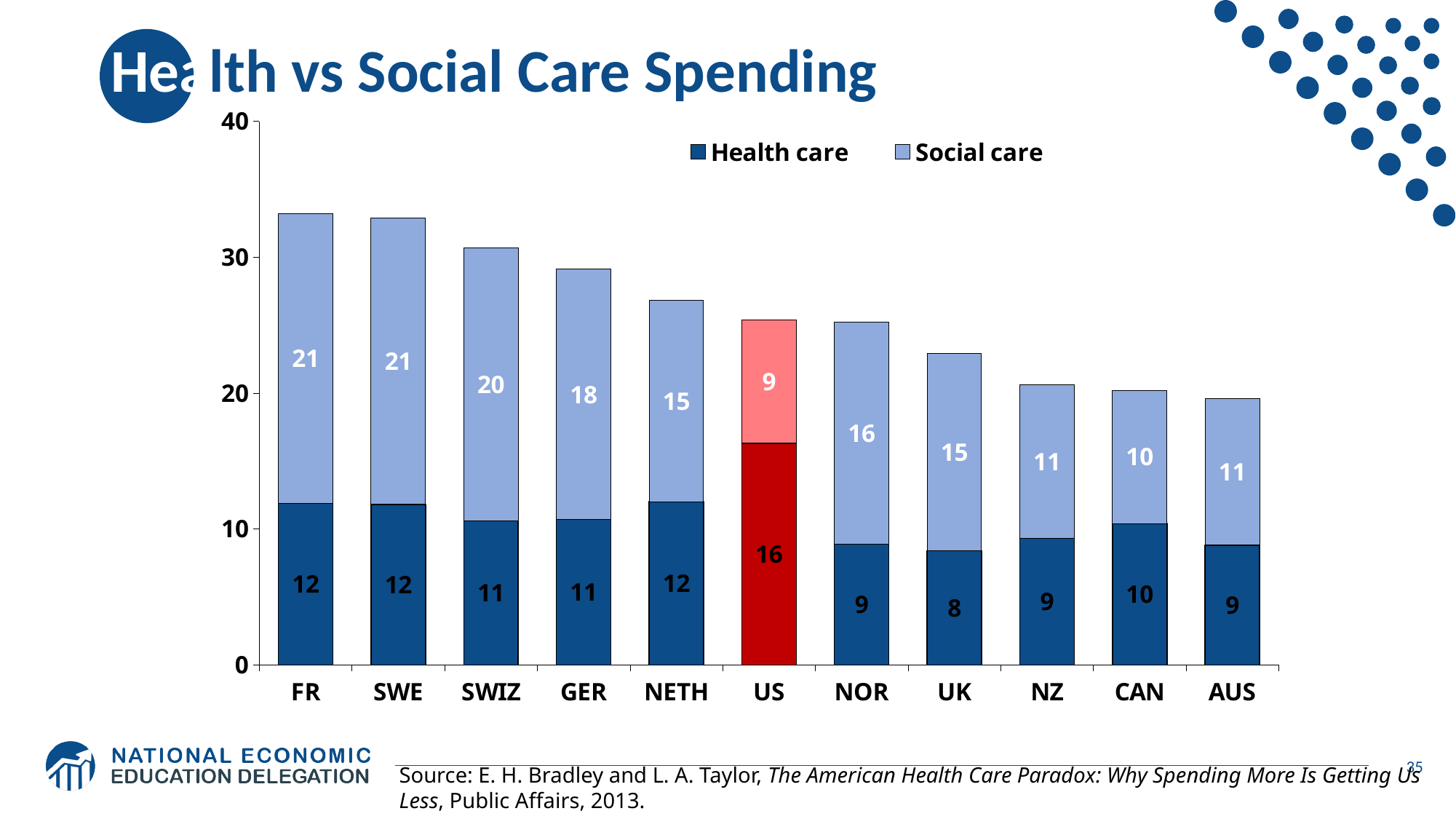
How many countries are shown on the x axis? 11 Which is larger, the Social care value for NOR or for NETH? NOR Which country has the lowest Social care value? US What is the total of the stacked bar for FR, using the printed labels? 33 What is the difference between the Health care values for the US and the UK? 8 What is the Health care value for the US? 16 Which country has the lowest Health care value? UK Which country has the highest Health care value? US What is the Social care value for GER? 18 How many series does the legend list? 2 What kind of chart is shown on the slide? Stacked bar chart Which country's bar is highlighted in red? US